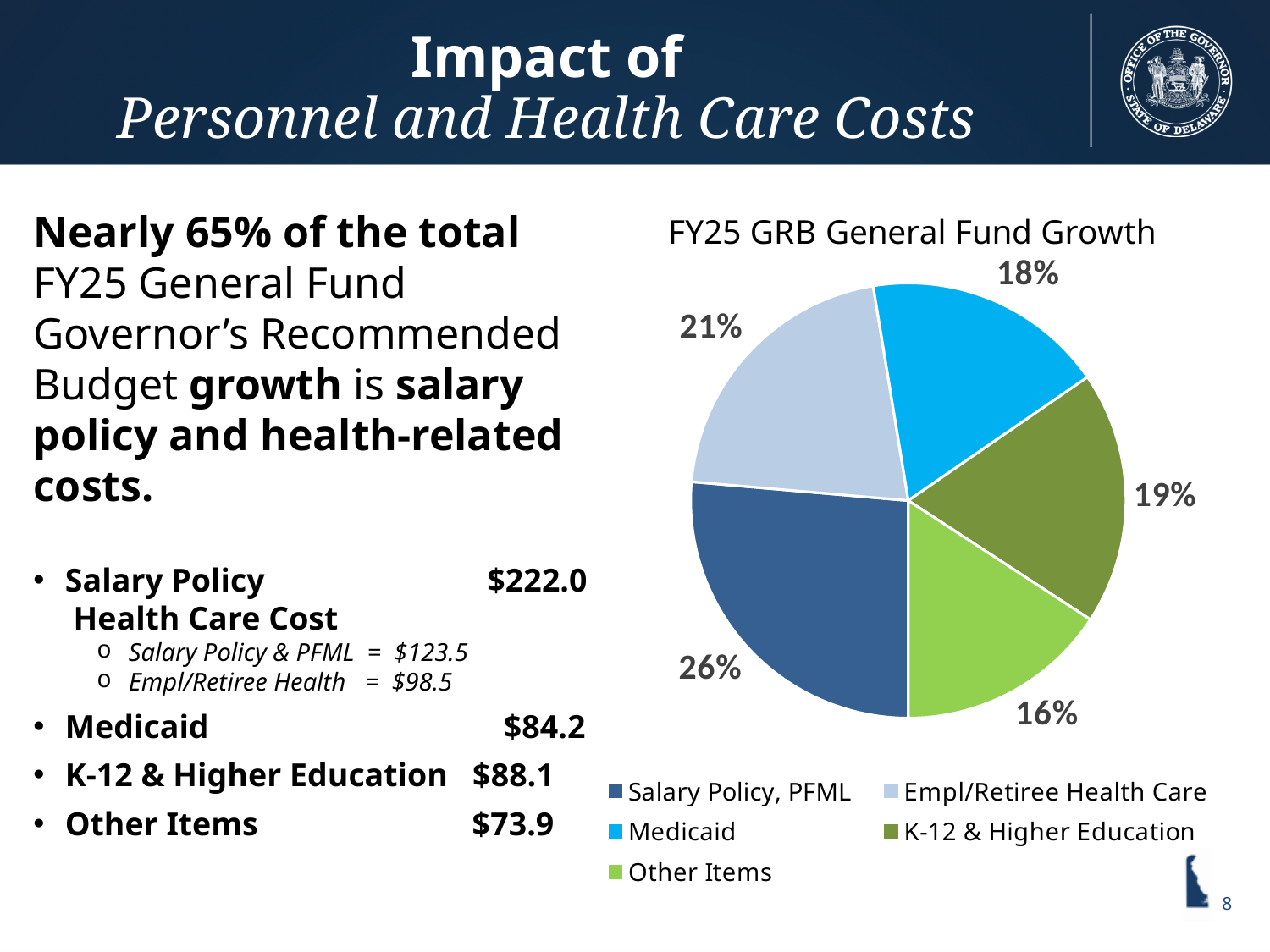
Which is larger, the Medicaid slice or the K-12 & Higher Education slice? K-12 & Higher Education What type of chart is shown on the slide? pie chart What percentage is shown for K-12 & Higher Education in the pie chart? 19% What percentage is shown for Medicaid in the pie chart? 18% What is the difference in percentage points between Salary Policy, PFML and Other Items? 10 Which category has the largest slice of the pie? Salary Policy, PFML Which category has the smallest slice of the pie? Other Items What share of the pie does Empl/Retiree Health Care represent? 21% What percentage is shown for Other Items in the pie chart? 16% What share of the pie does Salary Policy, PFML represent? 26% How many categories does the legend of the pie chart list? 5 What is the title of the chart? FY25 GRB General Fund Growth